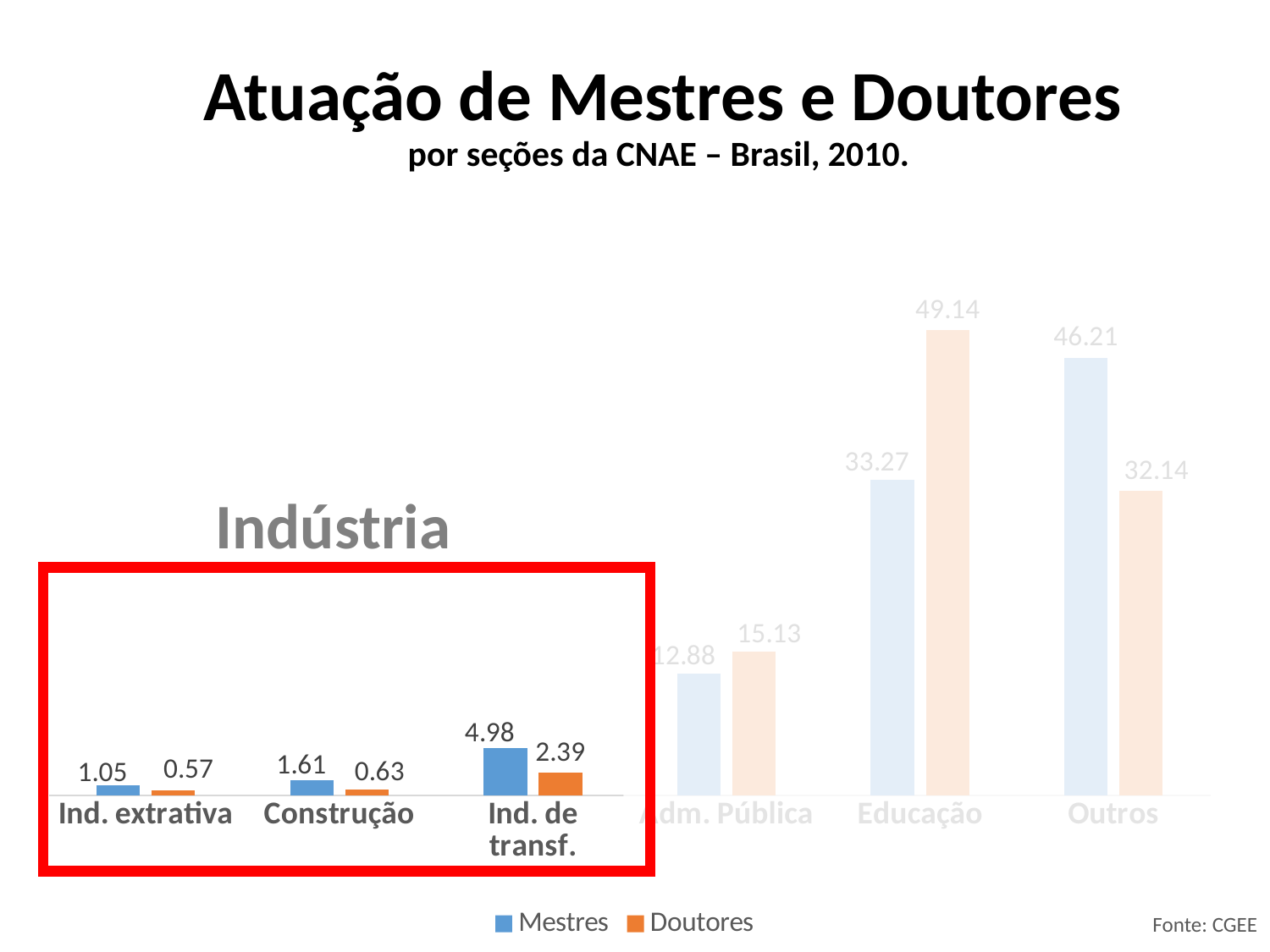
What is the value for Mestres in Ind. extrativa? 1.05 What is the value for Doutores in Construção? 0.63 Which category has the highest value for Doutores? Educação What is the value for Mestres in Educação? 33.27 How many categories are shown on the x axis? 6 How many series does the legend list? 2 Which three categories are grouped under the label 'Indústria' inside the red box? Ind. extrativa, Construção, Ind. de transf. What is the value for Doutores in Ind. de transf.? 2.39 Which category has the lowest value for Mestres? Ind. extrativa Which is larger in Adm. Pública, the Mestres value or the Doutores value? Doutores What kind of chart is shown on the slide? Bar chart What is the difference between the Mestres and Doutores values for Outros? 14.07